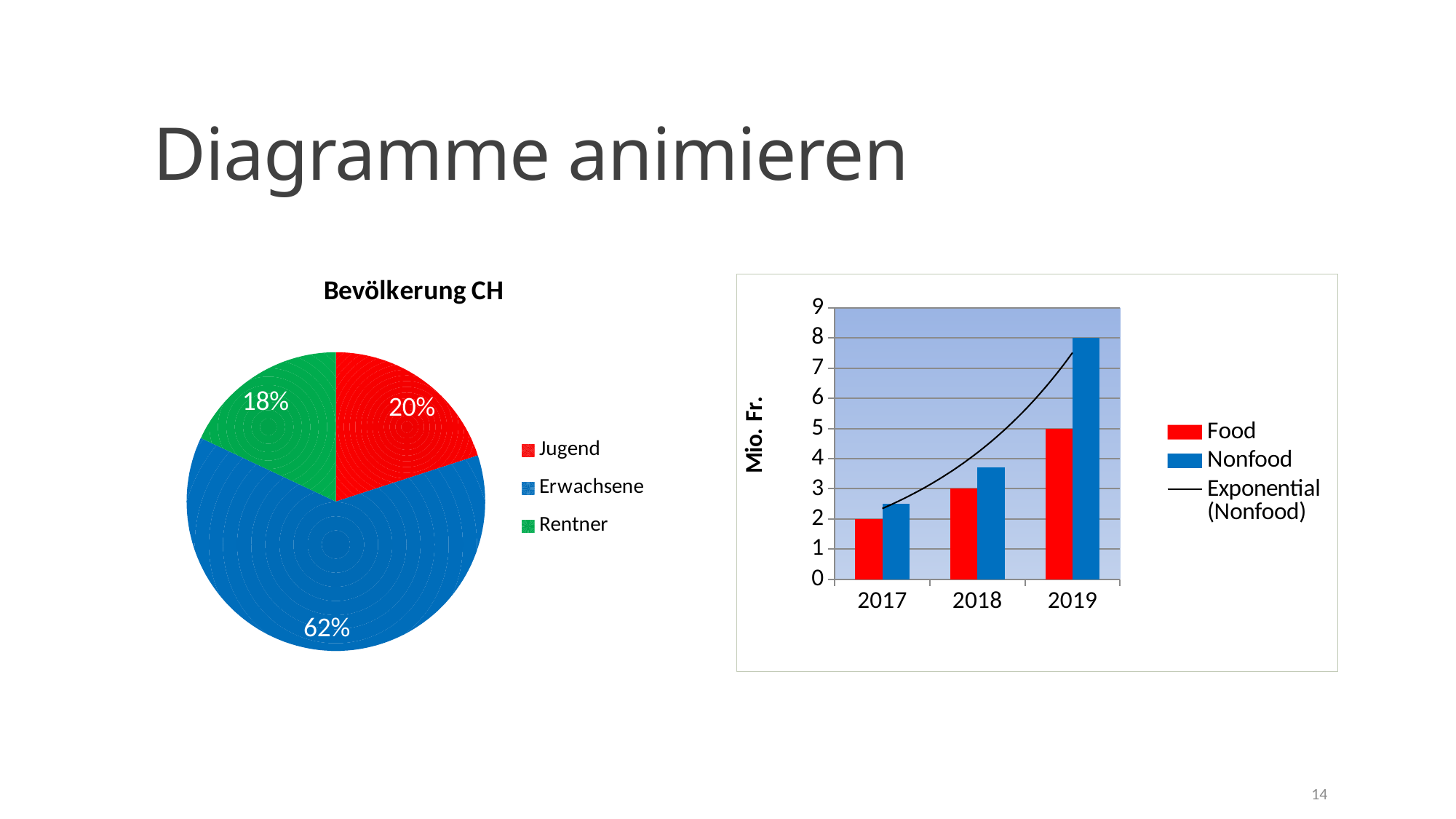
In the pie chart titled Bevölkerung CH, which category has the largest slice? Erwachsene In the bar chart on the right, is the value for Nonfood in 2018 greater or less than 3? greater In the bar chart on the right, how many entries does the legend list? 3 In the pie chart titled Bevölkerung CH, which category has the smallest slice? Rentner In the pie chart titled Bevölkerung CH, what share does Erwachsene have? 62% How many slices does the pie chart titled Bevölkerung CH have? 3 In the bar chart on the right, do the Nonfood values rise or fall from 2017 to 2019? rise In the pie chart titled Bevölkerung CH, what is the difference in percentage points between Jugend and Rentner? 2 In the bar chart on the right, what is the value for Nonfood in 2019? 8 In the bar chart on the right, what is the value for Food in 2019? 5 In the pie chart titled Bevölkerung CH, what share does Rentner have? 18% What type of chart is the chart on the right side of the slide? bar chart